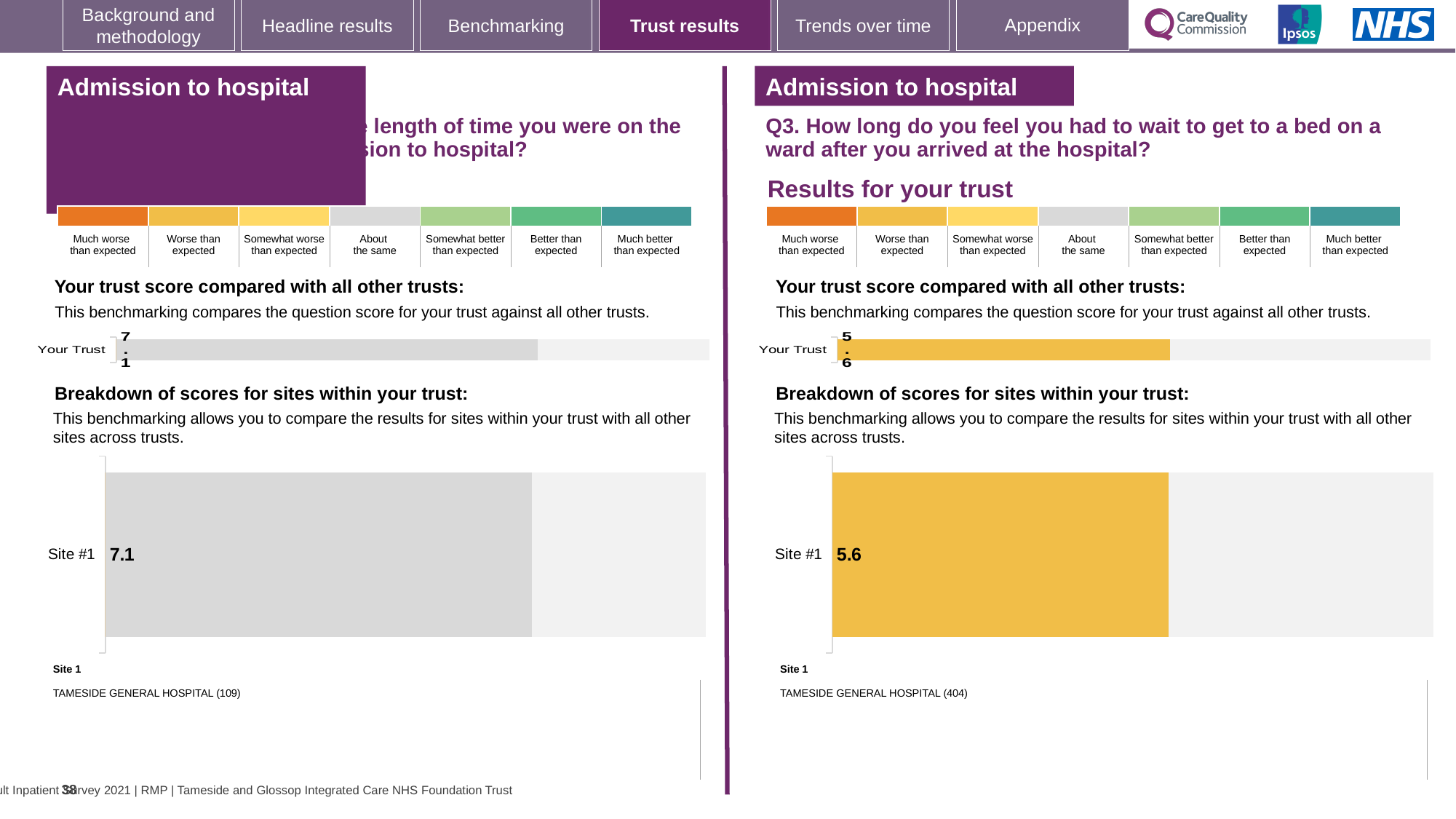
How many sites are shown in the right-hand 'Breakdown of scores for sites within your trust' chart? 1 On the left-hand side of the slide, what is the score shown for Your Trust in the trust score chart? 7.1 How many sites are shown in the left-hand 'Breakdown of scores for sites within your trust' chart? 1 In the left-hand 'Breakdown of scores for sites within your trust' chart, what is the score for Site #1? 7.1 What kind of chart is used to show the Site #1 score on the right-hand side of the slide? Bar chart What is the difference between the Site #1 score on the left-hand side (7.1) and the Site #1 score on the right-hand side (5.6)? 1.5 Which site name is listed as Site 1 below the right-hand breakdown chart? TAMESIDE GENERAL HOSPITAL (404) On the right-hand side of the slide (Q3, wait to get to a bed on a ward), what is the score shown for Your Trust? 5.6 What colour is the Site #1 bar in the right-hand breakdown chart (Q3)? Yellow/orange Which is larger: the Your Trust score on the left-hand side of the slide or the Your Trust score on the right-hand side (Q3)? Left-hand side (7.1) Is the Site #1 score on the right-hand side of the slide (Q3) the same as the Your Trust score on that side? Yes, both are 5.6 In the right-hand 'Breakdown of scores for sites within your trust' chart, what is the score for Site #1? 5.6